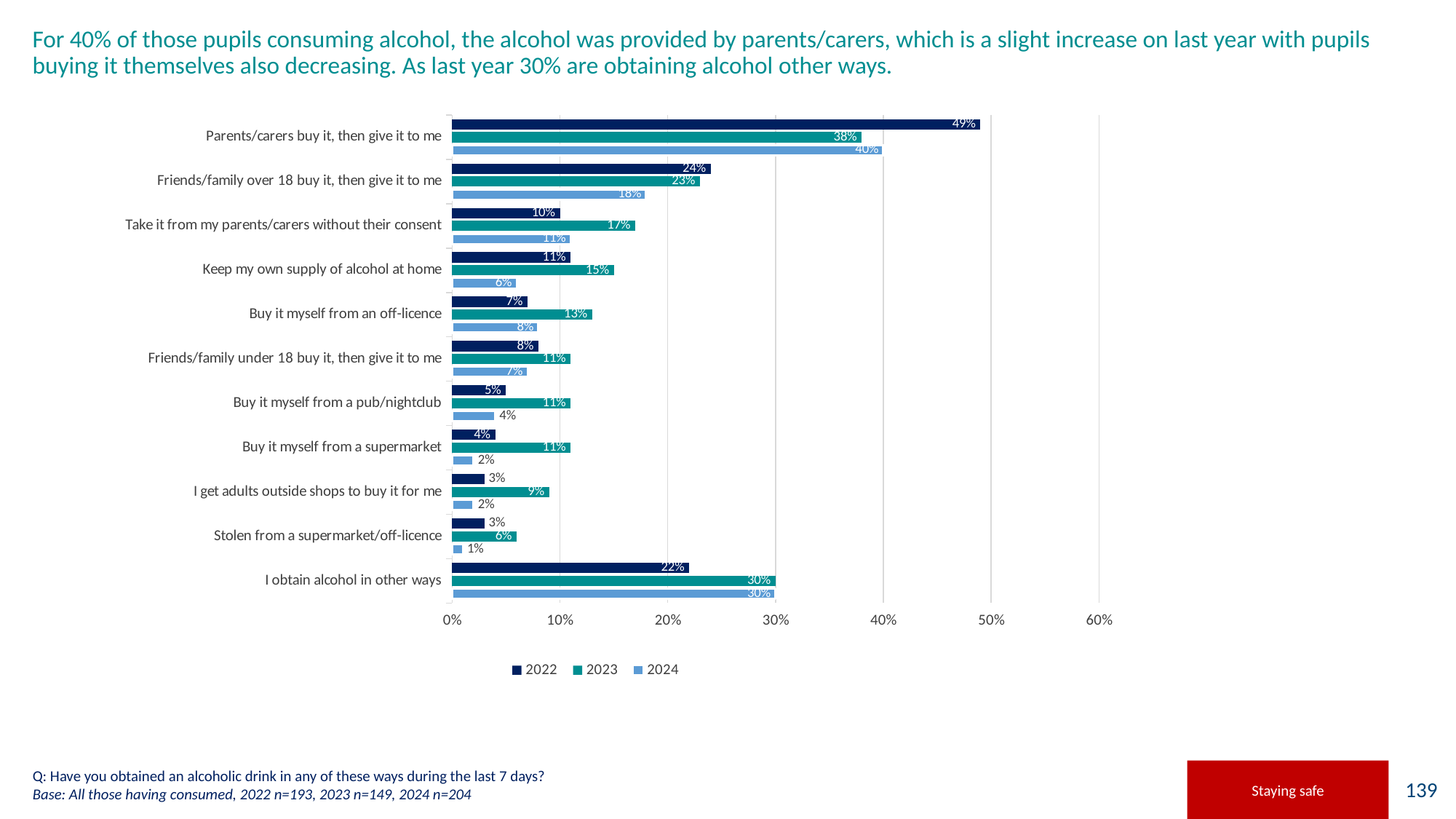
What is the 2023 value for "Take it from my parents/carers without their consent"? 17% Which years are listed in the chart legend? 2022, 2023, 2024 Which category has the highest 2022 value? Parents/carers buy it, then give it to me Which category has the lowest 2024 value? Stolen from a supermarket/off-licence What kind of chart is shown on the slide? Bar chart How many categories are shown on the chart? 11 How many series does the legend list? 3 What is the difference between the 2022 and 2024 values for "Parents/carers buy it, then give it to me"? 9% What is the 2024 value for "Stolen from a supermarket/off-licence"? 1% What is the 2024 value for "Parents/carers buy it, then give it to me"? 40% What is the 2022 value for "Parents/carers buy it, then give it to me"? 49% Which is larger for "Keep my own supply of alcohol at home": the 2023 value or the 2024 value? 2023